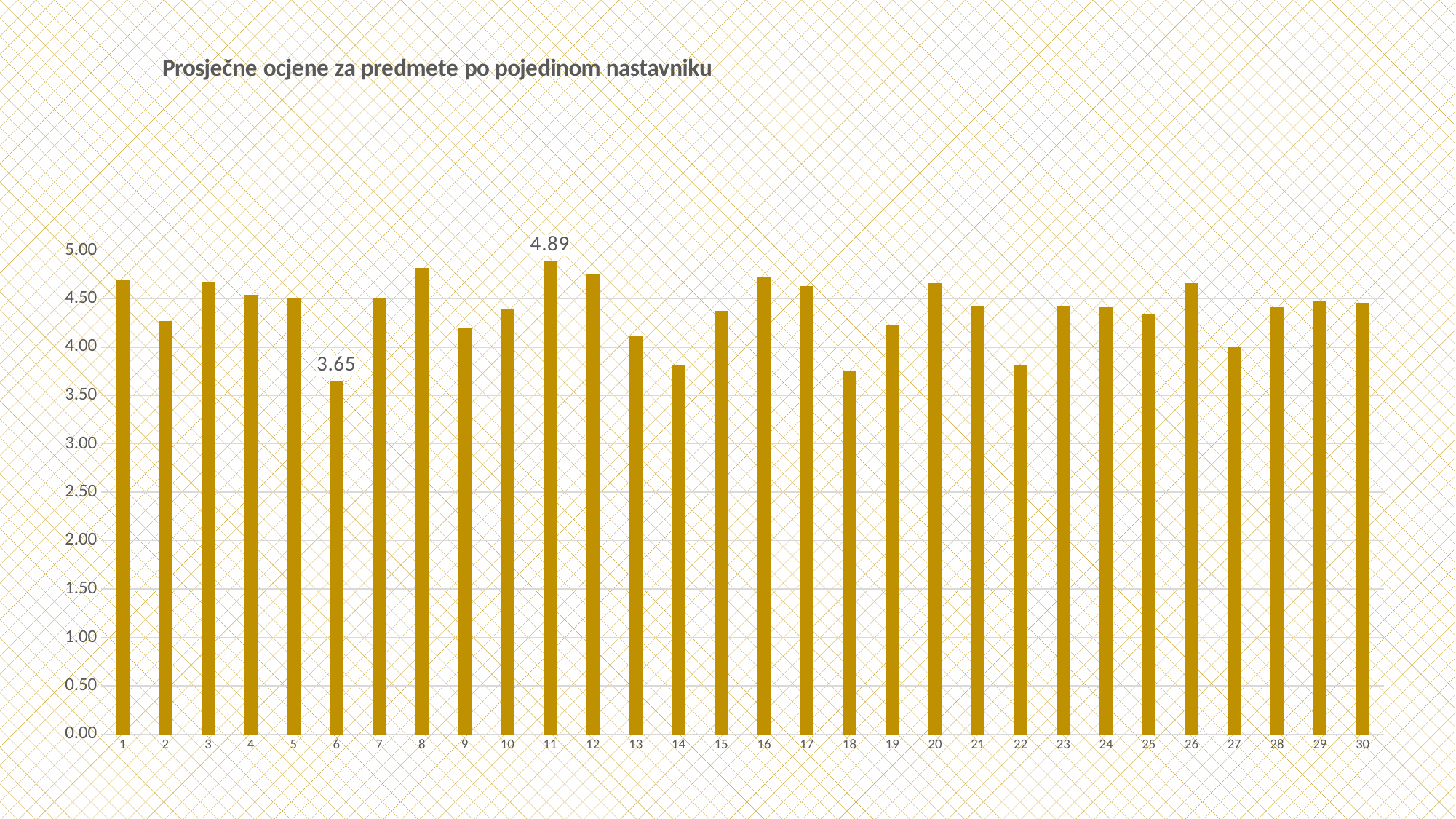
Which has the larger value, category 8 or category 14? 8 What is the value for category 11? 4.89 Which category has the lowest value? 6 What is the value for category 6? 3.65 What is the title of the chart? Prosječne ocjene za predmete po pojedinom nastavniku How many categories are shown on the x axis? 30 Which has the larger value, category 1 or category 2? 1 What kind of chart is shown on the slide? bar chart Is the value for category 18 greater or less than 4.00? less Is the value for category 8 greater or less than 4.50? greater Which category has the highest value? 11 What is the difference between the values for category 11 and category 6? 1.24